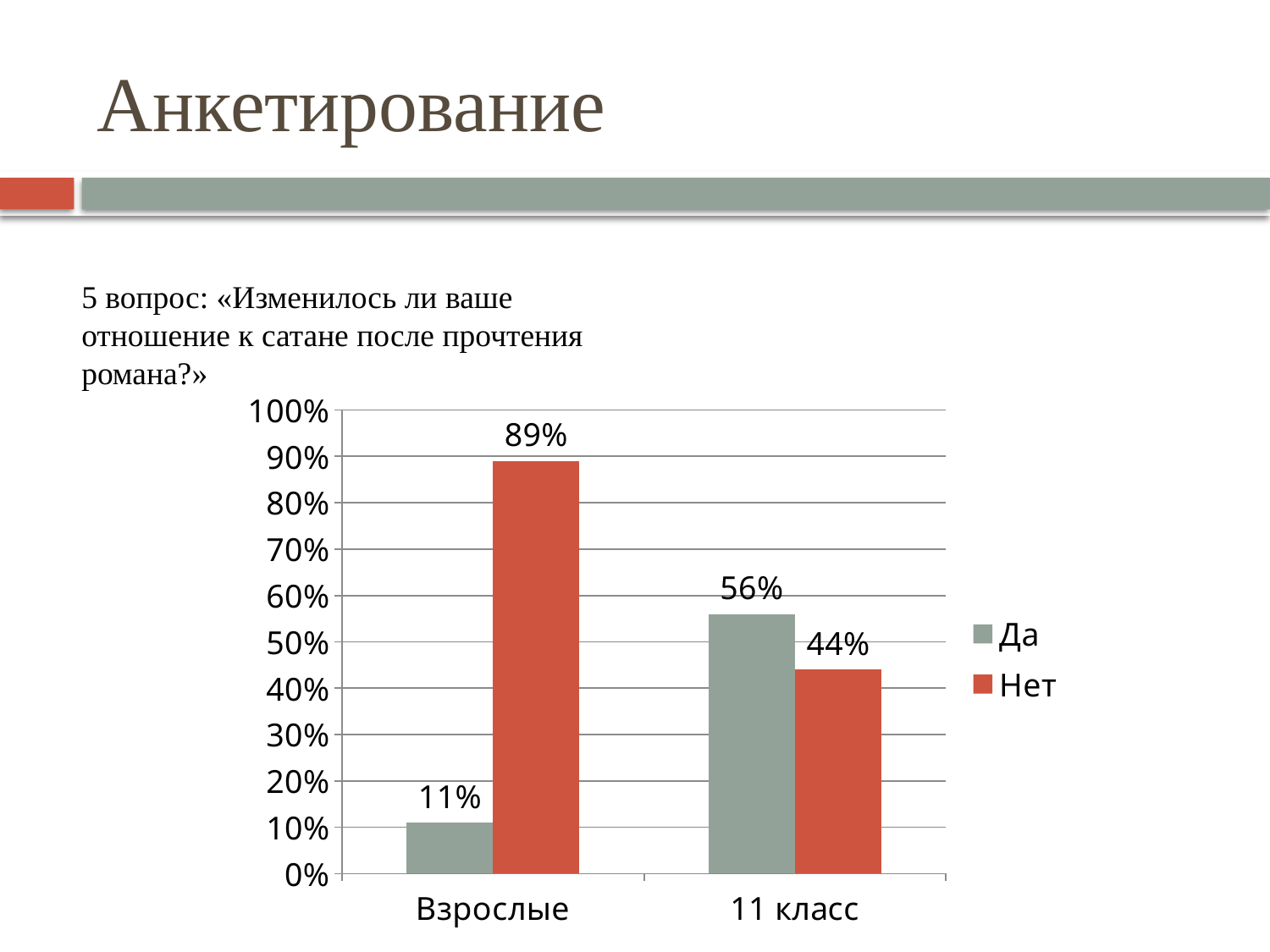
Which category has the lowest "Да" value? Взрослые What is the value for "Да" in the "11 класс" category? 56% Which category has the highest "Нет" value? Взрослые Which is larger for "11 класс": "Да" or "Нет"? Да What is the value for "Да" in the "Взрослые" category? 11% What kind of chart is shown on the slide? Bar chart What is the value for "Нет" in the "11 класс" category? 44% How many series does the legend list? 2 How many categories are shown on the x axis? 2 What is the value for "Нет" in the "Взрослые" category? 89% Which colour represents the "Нет" series? Red What is the difference between the "Нет" and "Да" values for "Взрослые"? 78%